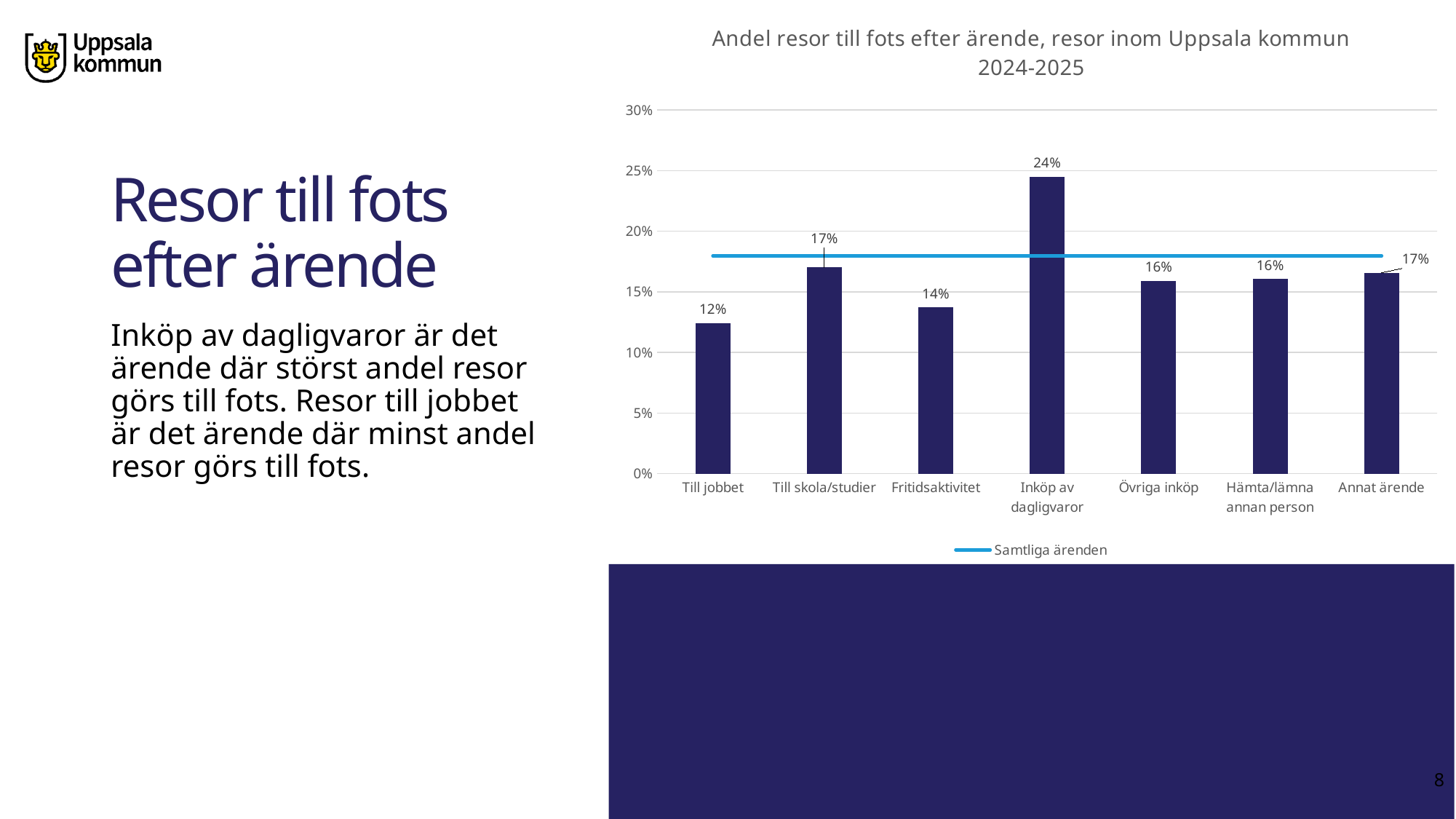
What is the value for Fritidsaktivitet? 14% What is the value for Till jobbet? 12% What is the difference between the values for Inköp av dagligvaror and Till jobbet? 12 percentage points Which category has the highest share of trips on foot? Inköp av dagligvaror What is the value for Övriga inköp? 16% Which category has the lowest share of trips on foot? Till jobbet What kind of chart is shown on the slide? Combination bar and line chart How many categories are shown on the x axis? 7 Which is larger, the value for Till skola/studier or the value for Fritidsaktivitet? Till skola/studier Is the Samtliga ärenden line greater or less than 15%? greater What is the value for Inköp av dagligvaror? 24% How many entries does the legend list? 1